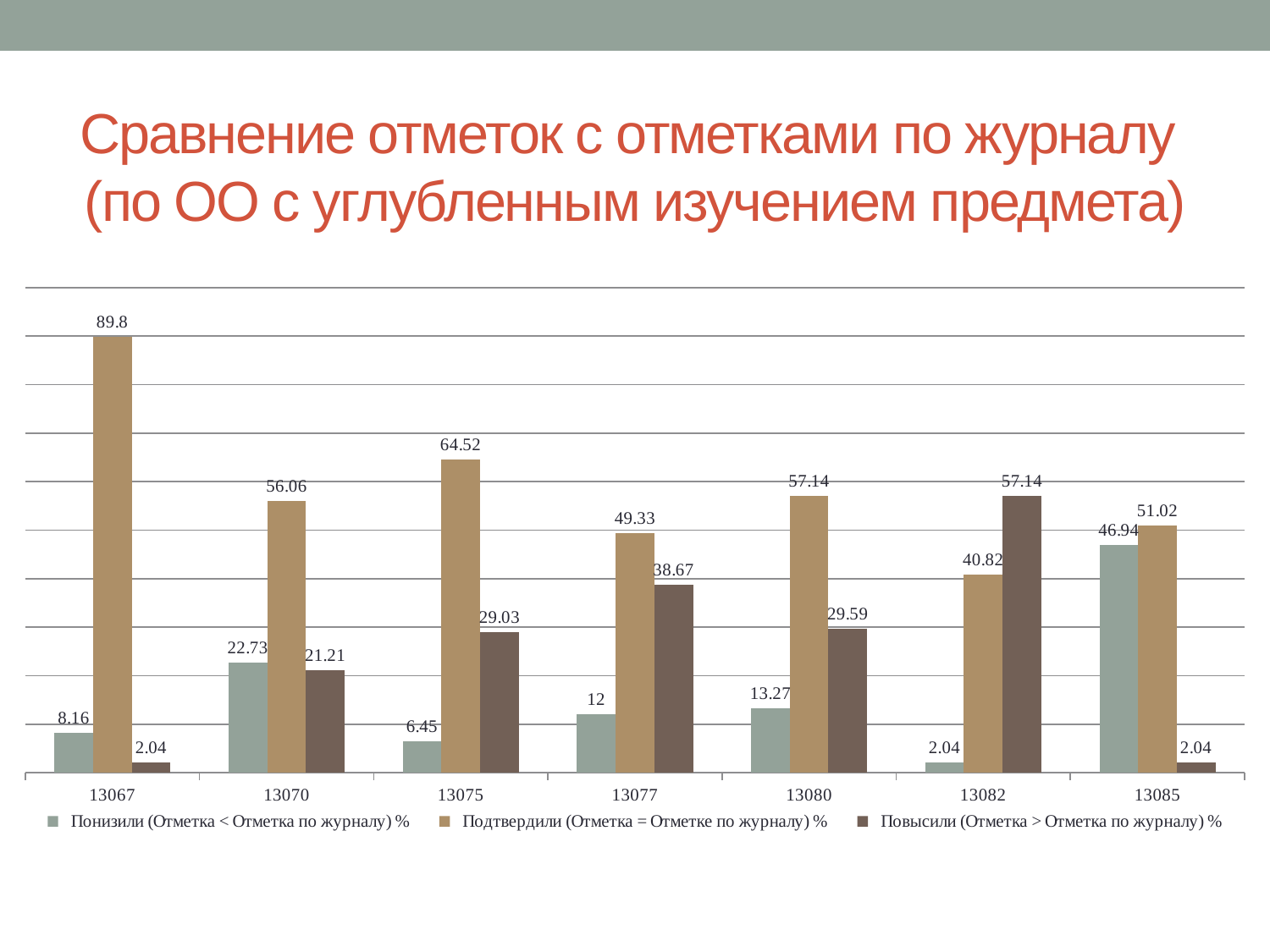
What is the value of 'Подтвердили (Отметка = Отметке по журналу) %' for category 13067? 89.8 What is the value of 'Понизили (Отметка < Отметка по журналу) %' for category 13080? 13.27 Which category has the highest value for 'Повысили (Отметка > Отметка по журналу) %'? 13082 For category 13070, which is larger: 'Понизили (Отметка < Отметка по журналу) %' or 'Повысили (Отметка > Отметка по журналу) %'? Понизили (Отметка < Отметка по журналу) % What is the value of 'Понизили (Отметка < Отметка по журналу) %' for category 13085? 46.94 What is the difference between the 'Подтвердили' and 'Понизили' values for category 13085? 4.08 How many categories are shown on the x axis? 7 What kind of chart is shown on the slide? bar chart How many series does the legend list? 3 What is the value of 'Повысили (Отметка > Отметка по журналу) %' for category 13077? 38.67 Which category has the lowest value for 'Понизили (Отметка < Отметка по журналу) %'? 13082 Which category has the highest value for 'Подтвердили (Отметка = Отметке по журналу) %'? 13067